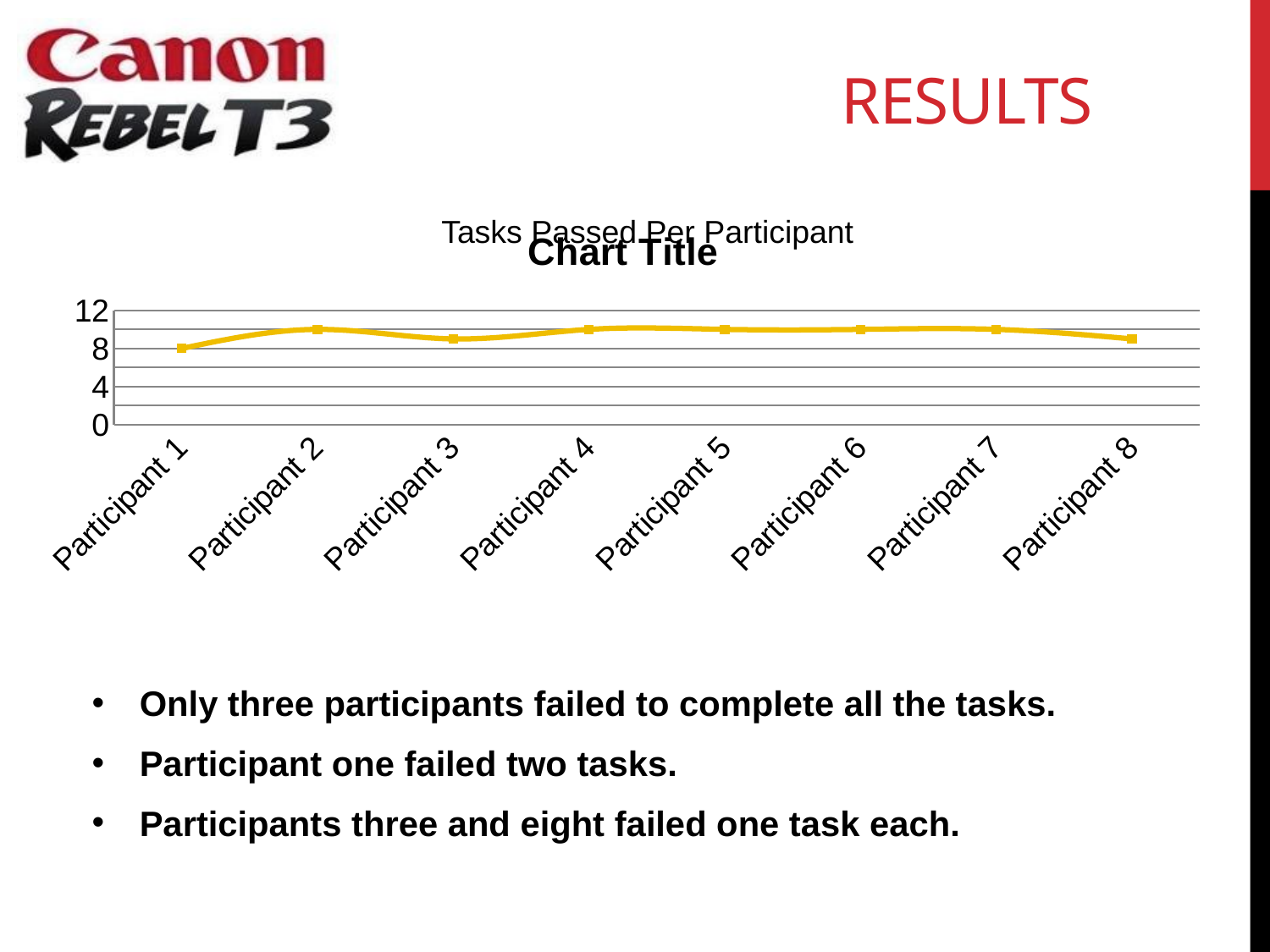
What is the value for Participant 1? 8 Which is larger, the value for Participant 1 or the value for Participant 6? Participant 6 Does the line rise or fall from Participant 7 to Participant 8? fall Which participant has the lowest value? Participant 1 Is the value for Participant 5 greater or less than 12? less Which is larger, the value for Participant 1 or the value for Participant 2? Participant 2 How many participants are plotted along the x axis? 8 What colour is the plotted line? yellow What kind of chart is shown on the slide? line chart Is the value for Participant 7 greater or less than 4? greater Is the value for Participant 2 greater or less than 8? greater Does the line rise or fall from Participant 1 to Participant 2? rise